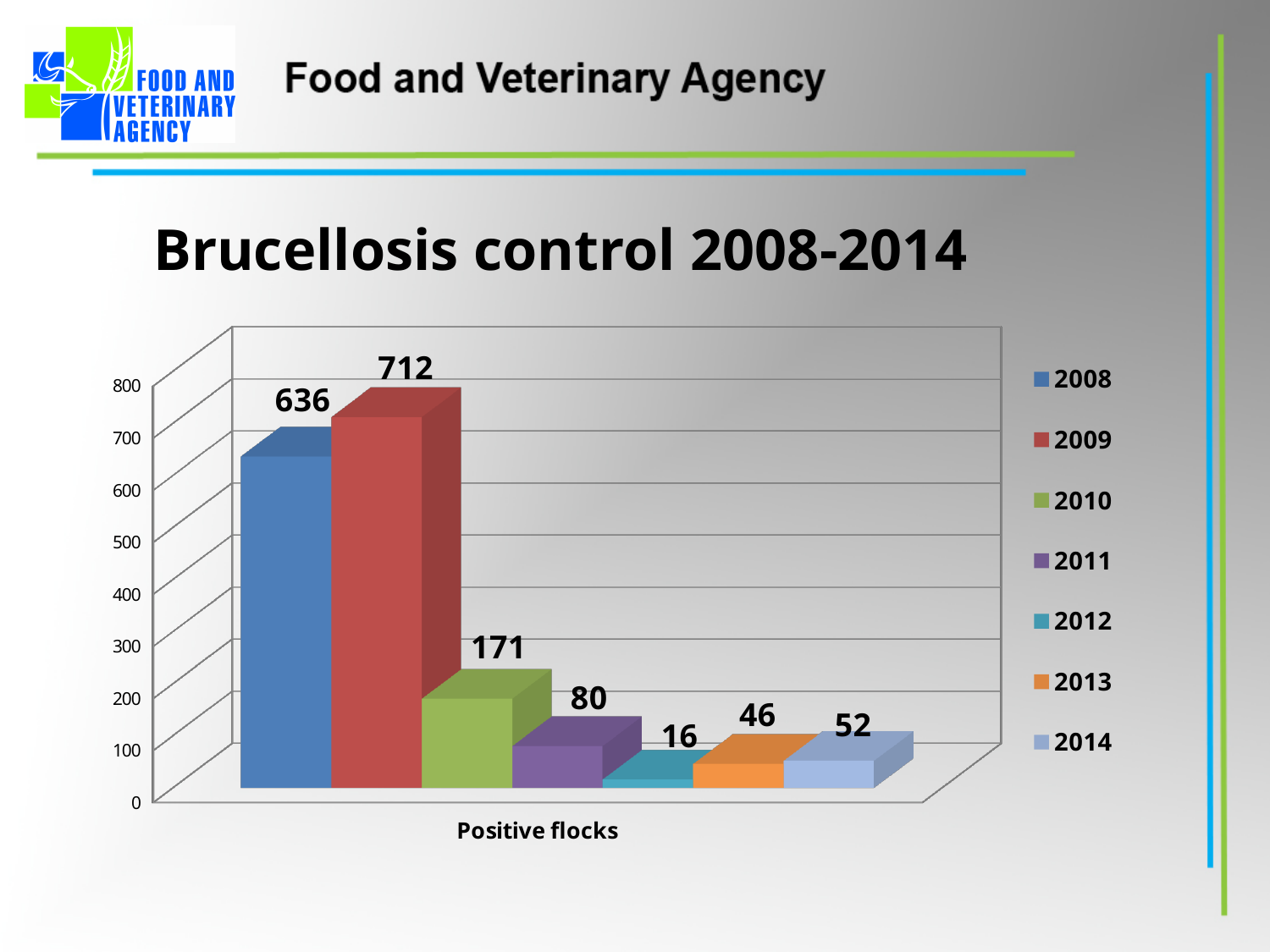
What is the difference between the values for 2010 and 2011? 91 Which is larger, the value for 2013 or the value for 2014? 2014 What is the difference between the values for 2009 and 2008? 76 What is the title of the chart on the slide? Brucellosis control 2008-2014 Which year has the lowest number of positive flocks? 2012 What is the value for 2014 in the Positive flocks chart? 52 How many series does the legend list? 7 Is the value for 2010 greater or less than 200? less What kind of chart is shown on the slide? bar chart What is the value for 2012 in the Positive flocks chart? 16 Which year has the highest number of positive flocks? 2009 What is the value for 2008 in the Positive flocks chart? 636